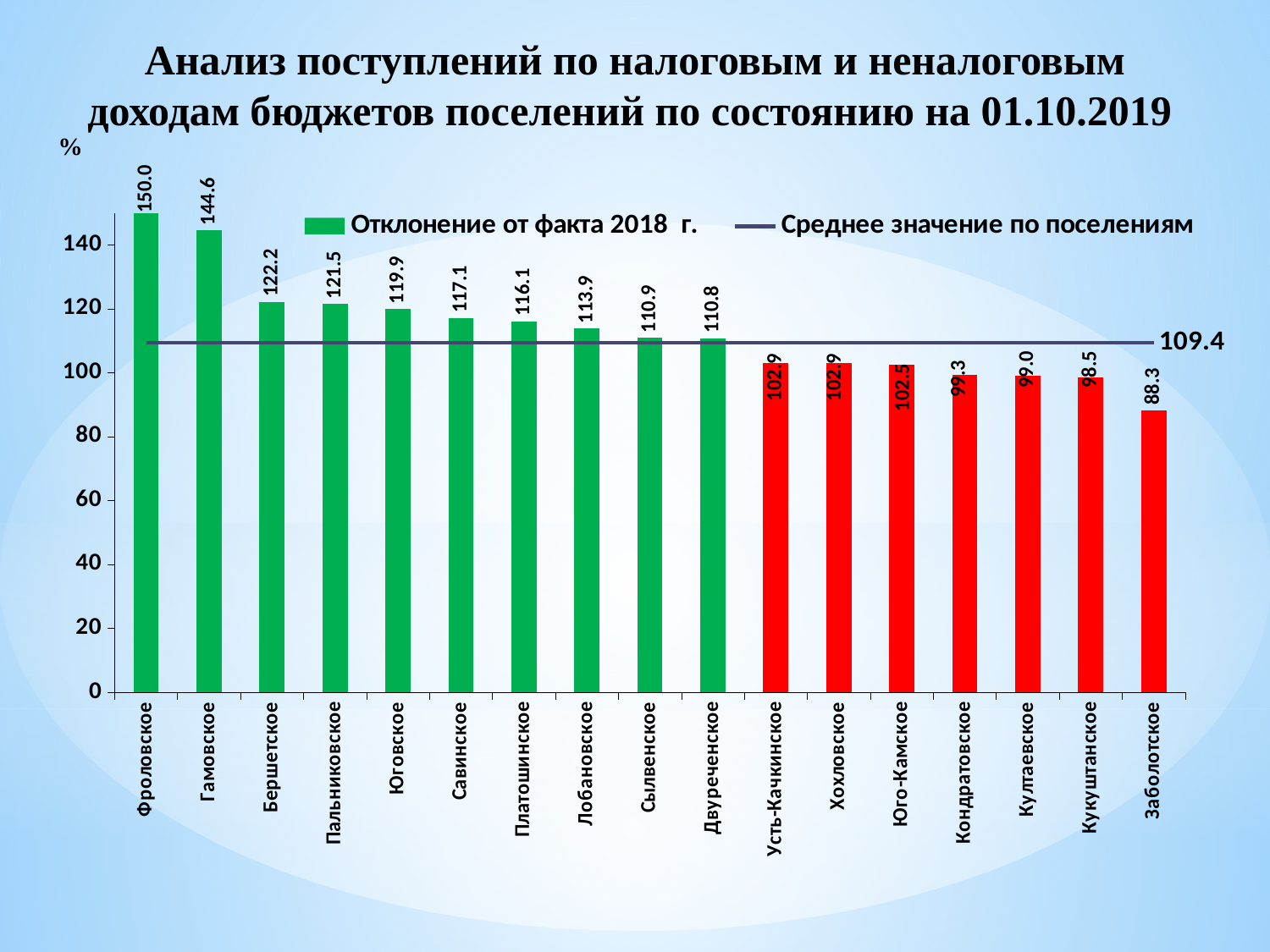
Which settlement has the highest value? Фроловское What is the value shown for the average line (Среднее значение по поселениям)? 109.4 Which is larger, the value for Бершетское or the value for Юговское? Бершетское How many entries does the legend list? 2 Which settlement has the lowest value? Заболотское Is the value for Кондратовское greater or less than 100? less What is the value for Заболотское? 88.3 What type of chart is shown on the slide? bar chart What is the value for Фроловское? 150.0 What is the value for Платошинское? 116.1 How many settlements are shown on the chart? 17 What is the difference between the values for Фроловское and Гамовское? 5.4